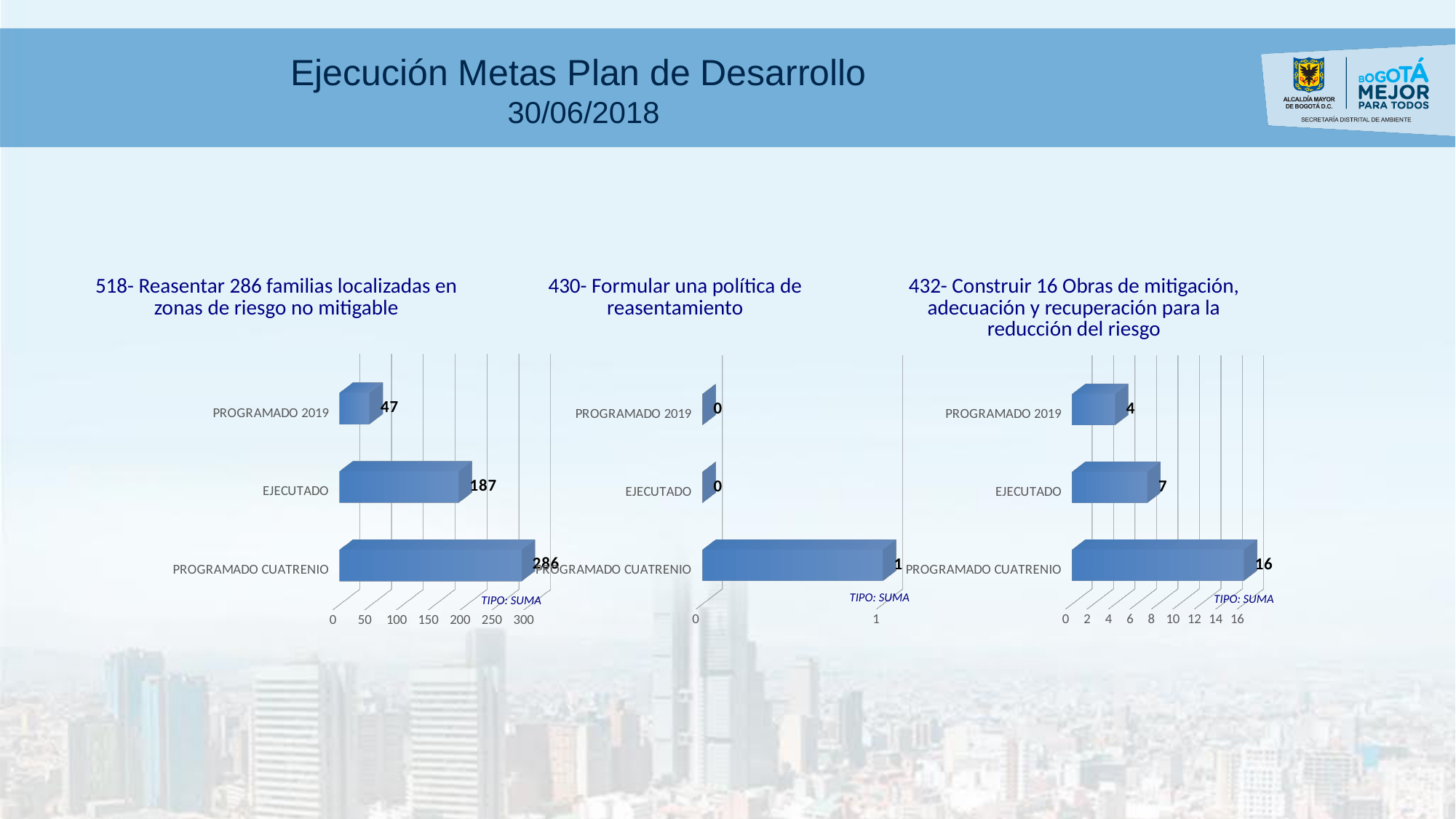
In the left chart (518- Reasentar 286 familias), what is the value for EJECUTADO? 187 In the left chart (518- Reasentar 286 familias), what is the value for PROGRAMADO 2019? 47 In the right chart (432- Construir 16 Obras de mitigación), what is the difference between PROGRAMADO CUATRENIO and EJECUTADO? 9 In the right chart (432- Construir 16 Obras de mitigación), what is the value for EJECUTADO? 7 How many categories does the right chart (432- Construir 16 Obras de mitigación) show? 3 In the middle chart (430- Formular una política de reasentamiento), what is the value for PROGRAMADO CUATRENIO? 1 In the right chart (432- Construir 16 Obras de mitigación), which category has the lowest value? PROGRAMADO 2019 In the left chart (518- Reasentar 286 familias), what is the difference between PROGRAMADO CUATRENIO and EJECUTADO? 99 What kind of chart is the left chart (518- Reasentar 286 familias)? Bar chart In the left chart (518- Reasentar 286 familias), is the value for EJECUTADO greater or less than 150? greater In the left chart (518- Reasentar 286 familias), which category has the highest value? PROGRAMADO CUATRENIO In the middle chart (430- Formular una política de reasentamiento), what is the value for EJECUTADO? 0